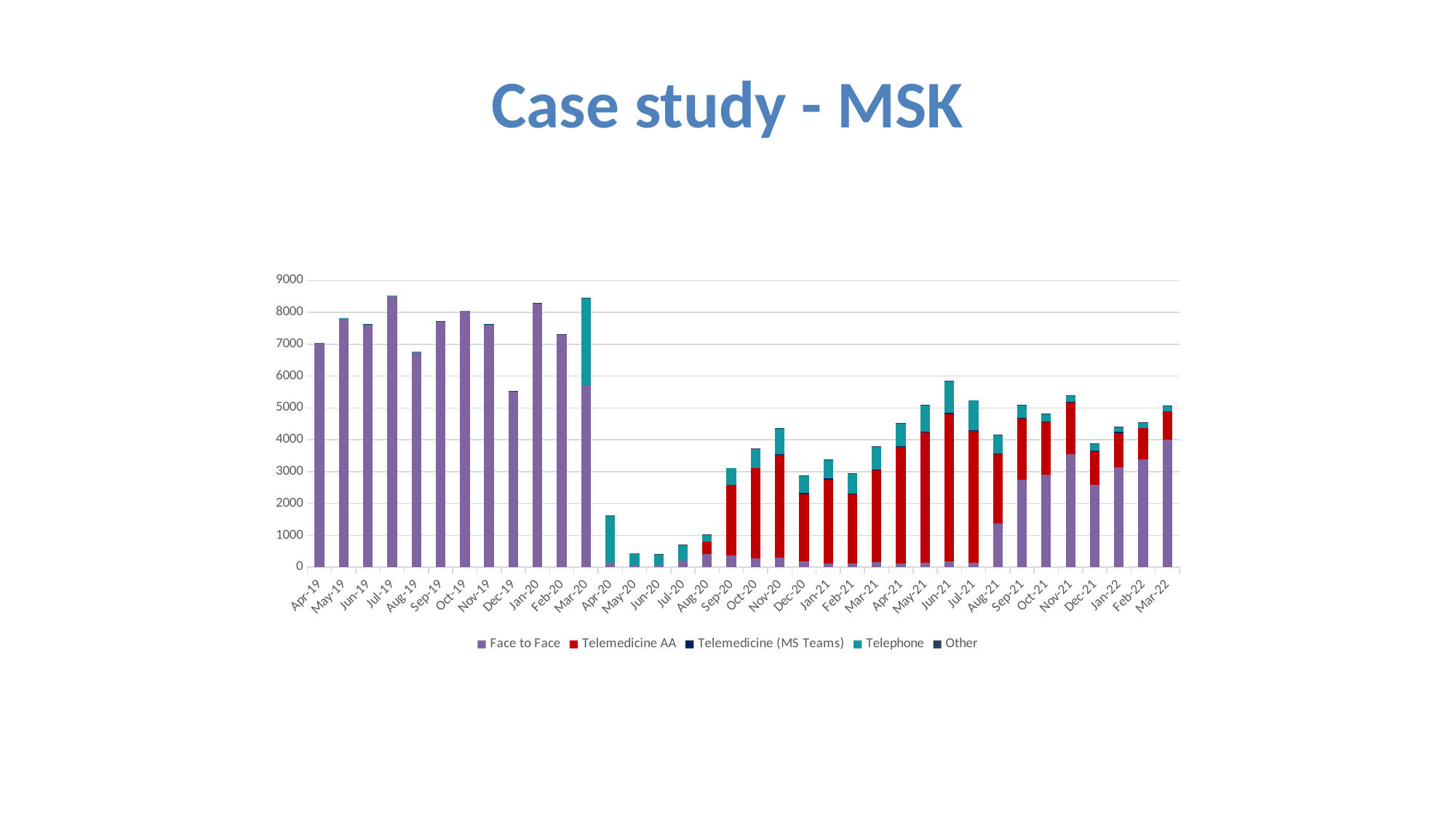
Is the total for Dec-19 greater or less than 6000? less How many months (categories) are plotted along the x axis? 36 How many series does the legend list? 5 Is the total for Apr-20 greater or less than 2000? less Is the total for Jun-21 greater or less than 5000? greater What kind of chart is shown on the slide? Stacked bar chart What is the title of the slide containing the chart? Case study - MSK Which has the larger total, Apr-20 or Jun-20? Apr-20 Do the bar totals generally rise or fall from Apr-20 to Jun-21? rise Which has the larger total, Jan-20 or Feb-20? Jan-20